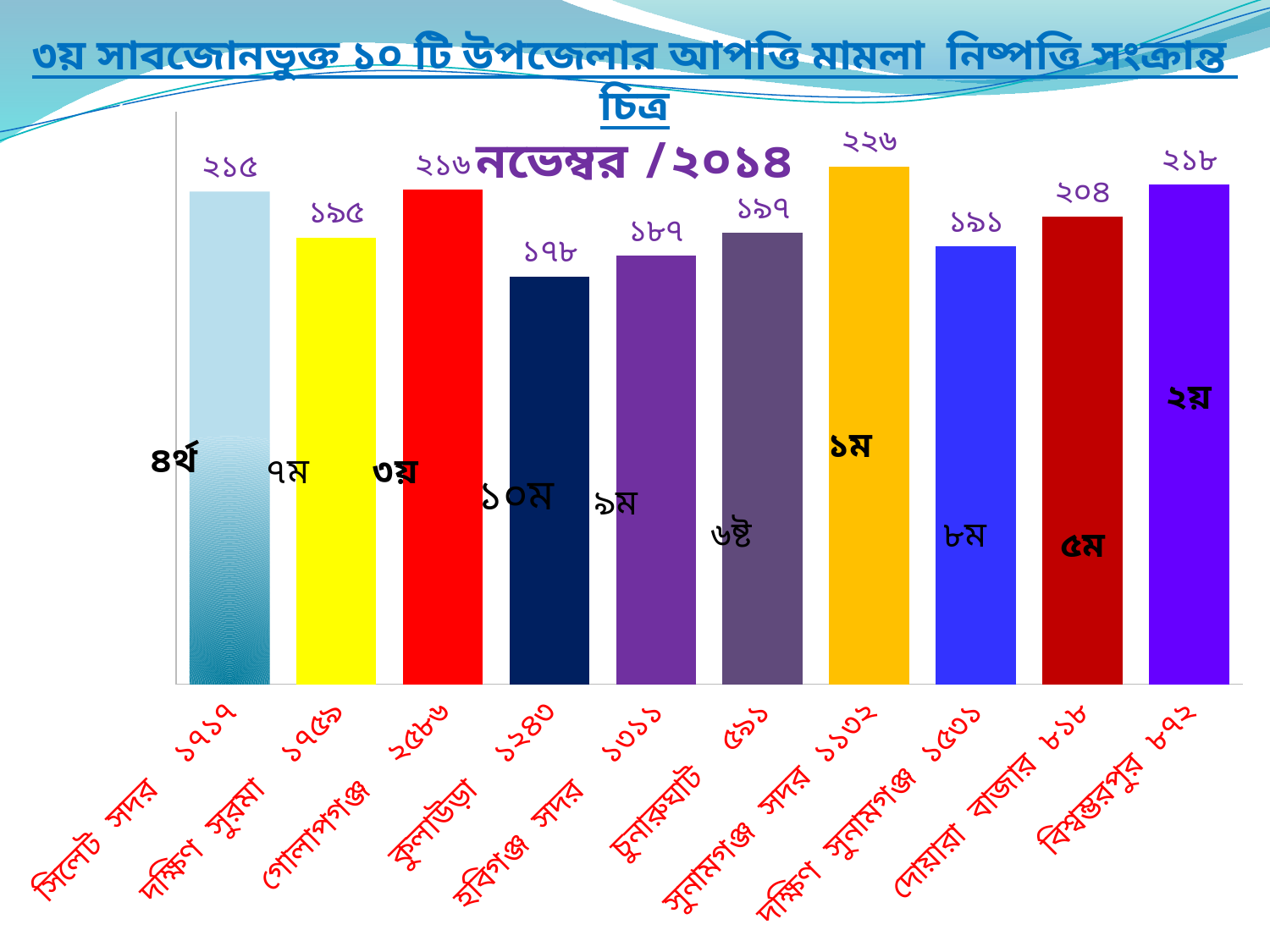
What is the difference between the values for সুনামগঞ্জ সদর and কুলাউড়া? ৪৮ Which rank label is printed on the bar for সুনামগঞ্জ সদর? ১ম What is the value for চুনারুঘাট? ১৯৭ What is the value for কুলাউড়া? ১৭৮ Which month and year does the chart refer to? নভেম্বর /২০১৪ Which upazila has the highest value? সুনামগঞ্জ সদর What kind of chart is shown on the slide? bar chart What is the value for সুনামগঞ্জ সদর? ২২৬ Which upazila has the lowest value? কুলাউড়া What is the value for দোয়ারা বাজার? ২০৪ How many upazilas are shown in the chart? ১০ Which is larger, the value for বিশ্বম্ভরপুর or the value for দোয়ারা বাজার? বিশ্বম্ভরপুর